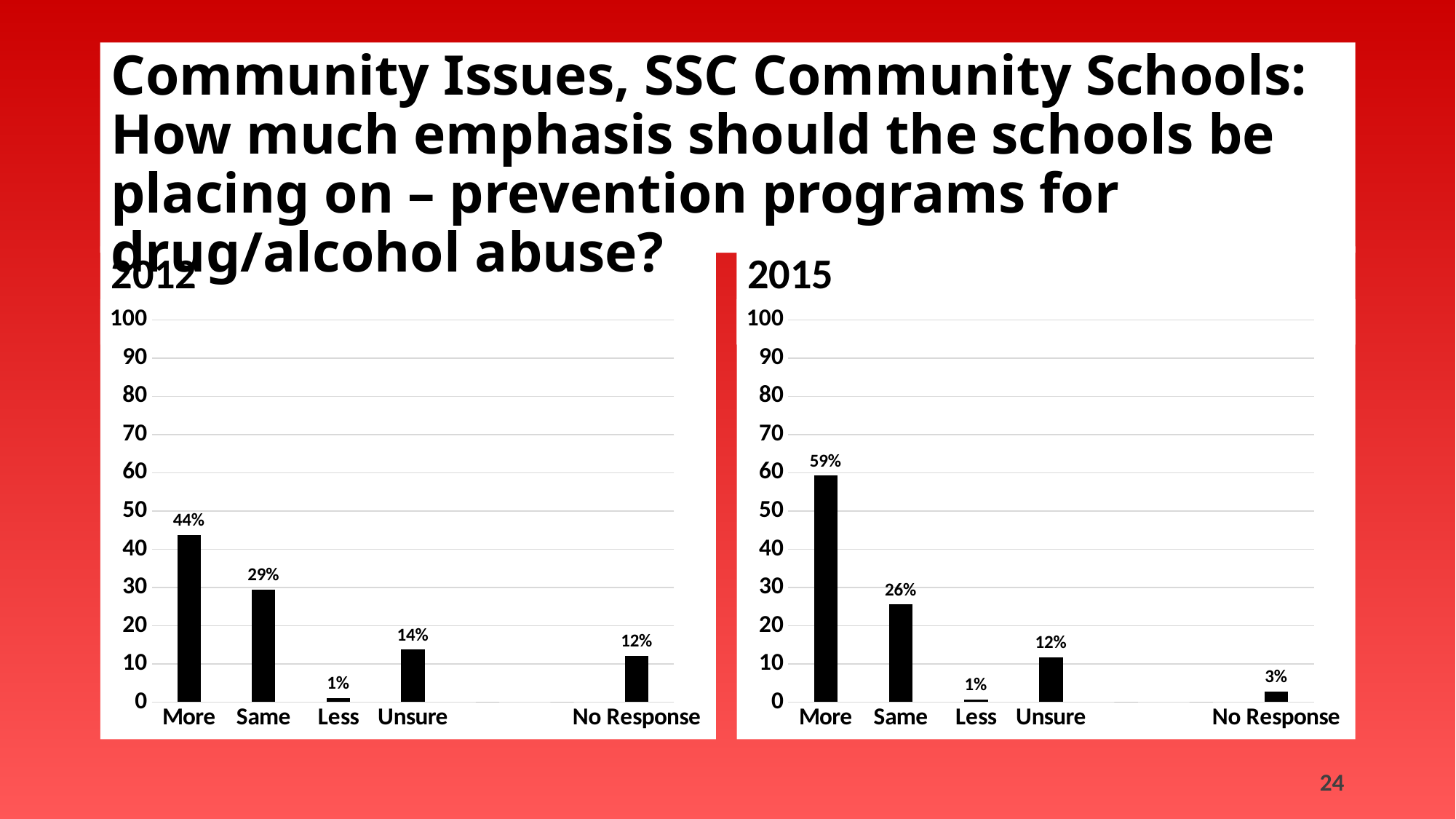
In the 2012 chart, is the value for Same greater or less than 30? less In the 2015 chart, what is the value for No Response? 3% Which is larger: More in the 2012 chart or More in the 2015 chart? More in the 2015 chart In the 2015 chart, which category has the lowest value? Less In the 2012 chart, what is the difference between Unsure and No Response? 2% In the 2012 chart, what is the value for More? 44% What kind of chart is the 2012 chart? bar chart In the 2015 chart, what is the difference between More and Same? 33% In the 2015 chart, what is the value for Same? 26% What is the title of the chart on the right? 2015 In the 2012 chart, which category has the highest value? More How many categories are shown in the 2015 chart? 5